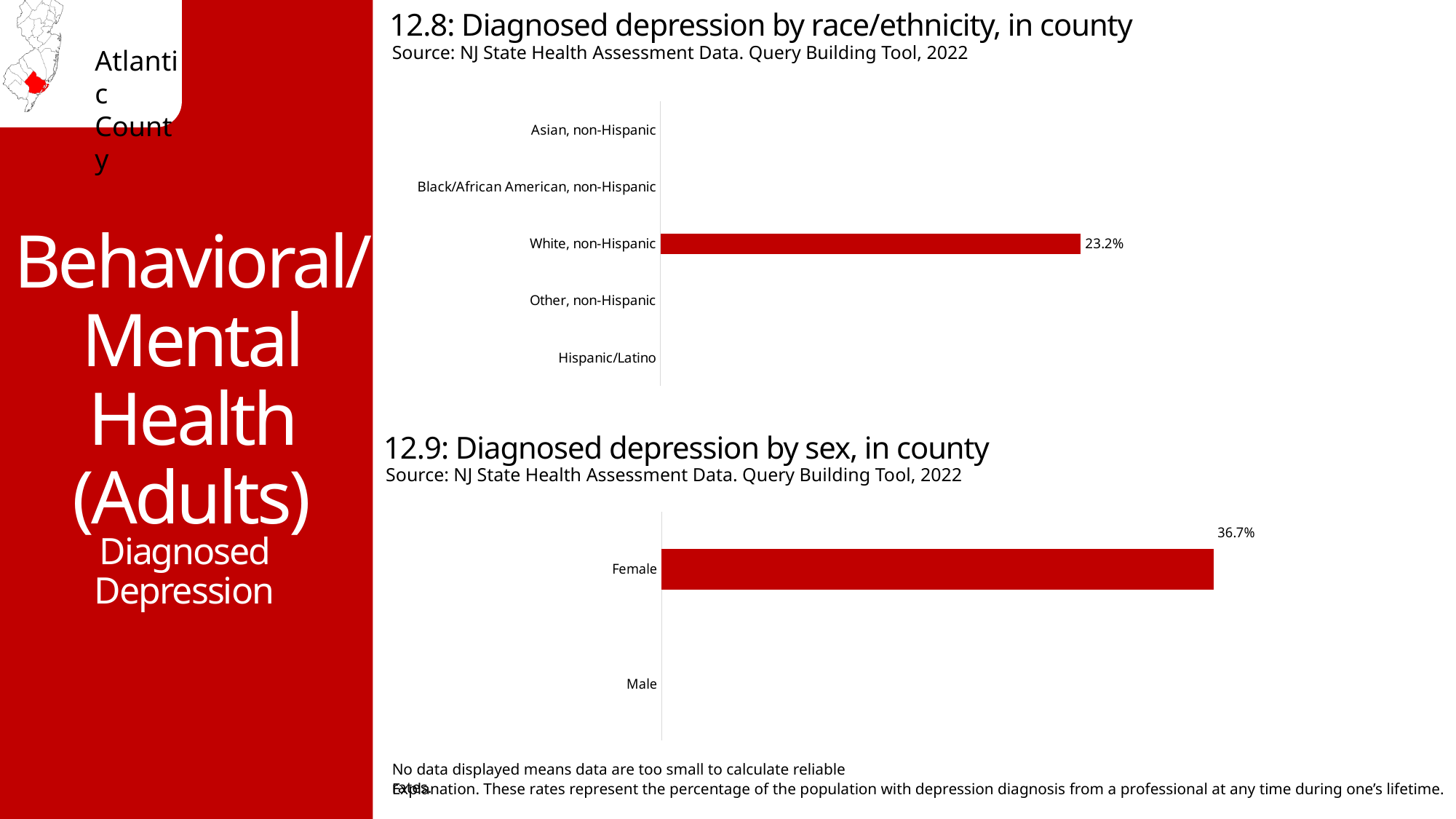
What colour are the bars in the charts on this slide? Red What kind of chart is '12.8: Diagnosed depression by race/ethnicity, in county'? Bar chart In the chart '12.9: Diagnosed depression by sex, in county', which category has a bar displayed? Female What is the difference between the Female value in chart 12.9 and the White, non-Hispanic value in chart 12.8? 13.5% In the chart '12.9: Diagnosed depression by sex, in county', what is the value for Female? 36.7% In the chart '12.8: Diagnosed depression by race/ethnicity, in county', which category has a bar displayed? White, non-Hispanic In the chart '12.8: Diagnosed depression by race/ethnicity, in county', how many race/ethnicity categories are listed on the axis? 5 What kind of chart is '12.9: Diagnosed depression by sex, in county'? Bar chart What is the source cited for the chart '12.8: Diagnosed depression by race/ethnicity, in county'? NJ State Health Assessment Data. Query Building Tool, 2022 In the chart '12.8: Diagnosed depression by race/ethnicity, in county', what is the value for White, non-Hispanic? 23.2% In the chart '12.9: Diagnosed depression by sex, in county', how many sex categories are listed on the axis? 2 Is the Female value in the chart '12.9: Diagnosed depression by sex, in county' larger than the White, non-Hispanic value in the chart '12.8: Diagnosed depression by race/ethnicity, in county'? Yes